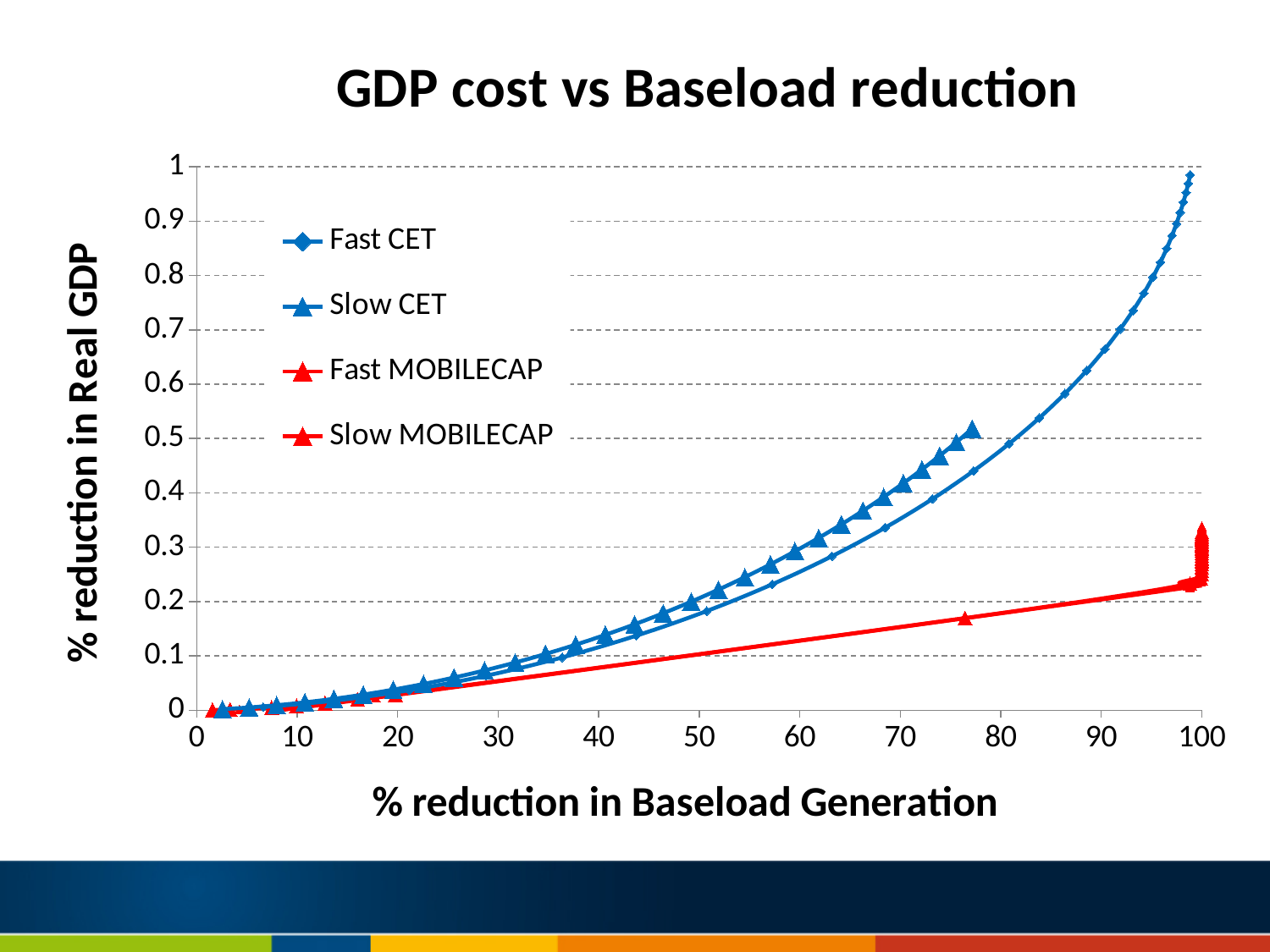
Which series reaches the highest % reduction in Real GDP? Fast CET Is the Fast CET value at 90% reduction in Baseload Generation greater or less than 0.6? greater How many series does the legend list? 4 Is the Fast CET value at 100% reduction in Baseload Generation greater or less than 0.9? greater At 90% reduction in Baseload Generation, which series has the larger % reduction in Real GDP, Fast CET or Fast MOBILECAP? Fast CET What is the label of the vertical axis? % reduction in Real GDP Does the Fast CET series rise or fall as the % reduction in Baseload Generation increases? rises At 70% reduction in Baseload Generation, which series has the larger % reduction in Real GDP, Slow CET or Fast CET? Slow CET Is the Fast MOBILECAP value at about 76% reduction in Baseload Generation greater or less than 0.1? greater What is the title of the chart? GDP cost vs Baseload reduction What kind of chart is shown on the slide? line chart